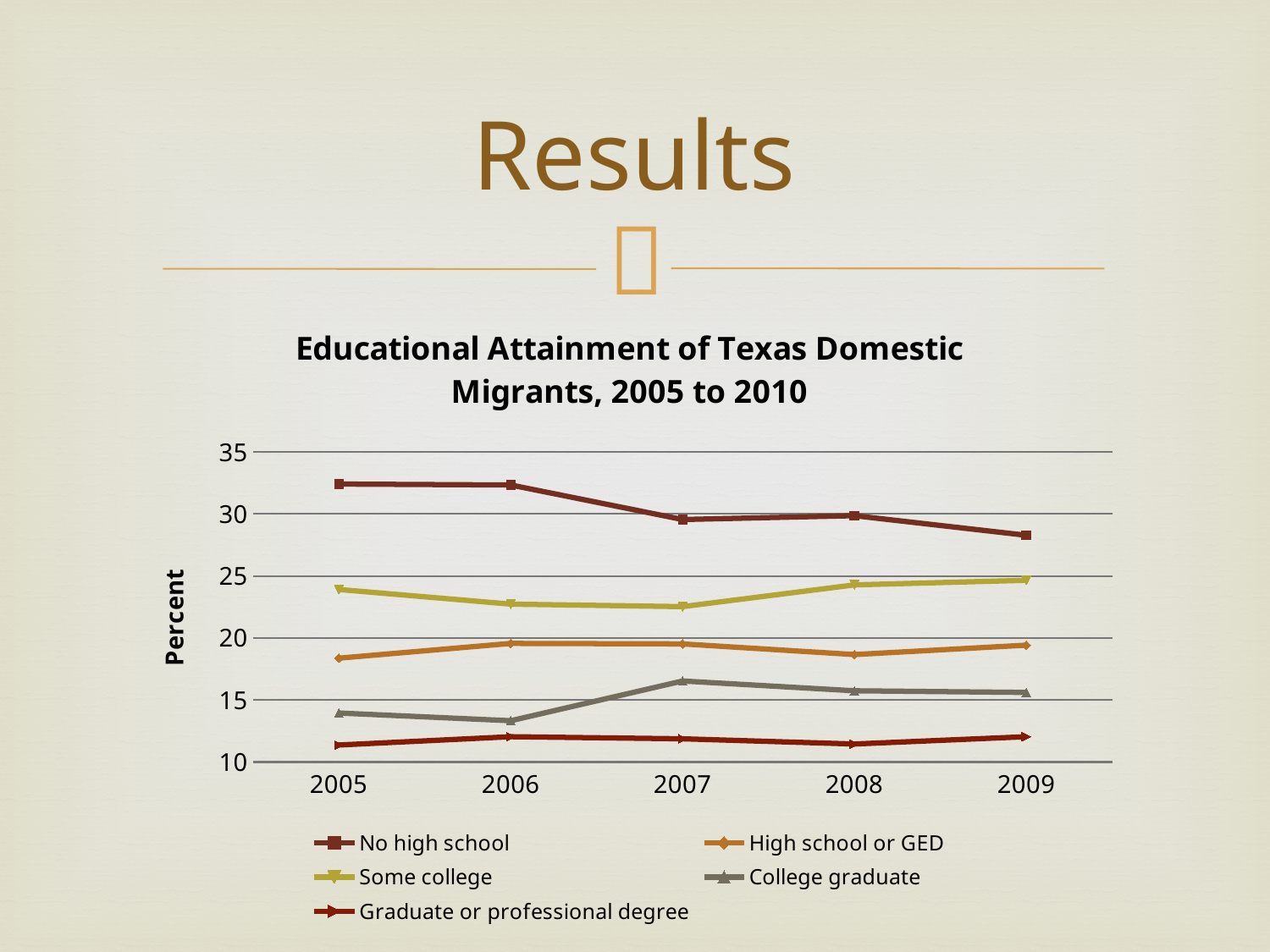
In 2007, which is larger: Some college or High school or GED? Some college Is the value for No high school in 2009 greater or less than 30? less How many series does the legend list? 5 Is the value for Some college in 2006 greater or less than 25? less Is the value for No high school in 2005 greater or less than 30? greater Which series has the highest value in 2005? No high school What kind of chart is shown on the slide? line chart How many years are plotted along the x axis? 5 Which series has the lowest value in 2009? Graduate or professional degree Does the No high school series rise or fall from 2005 to 2009? fall